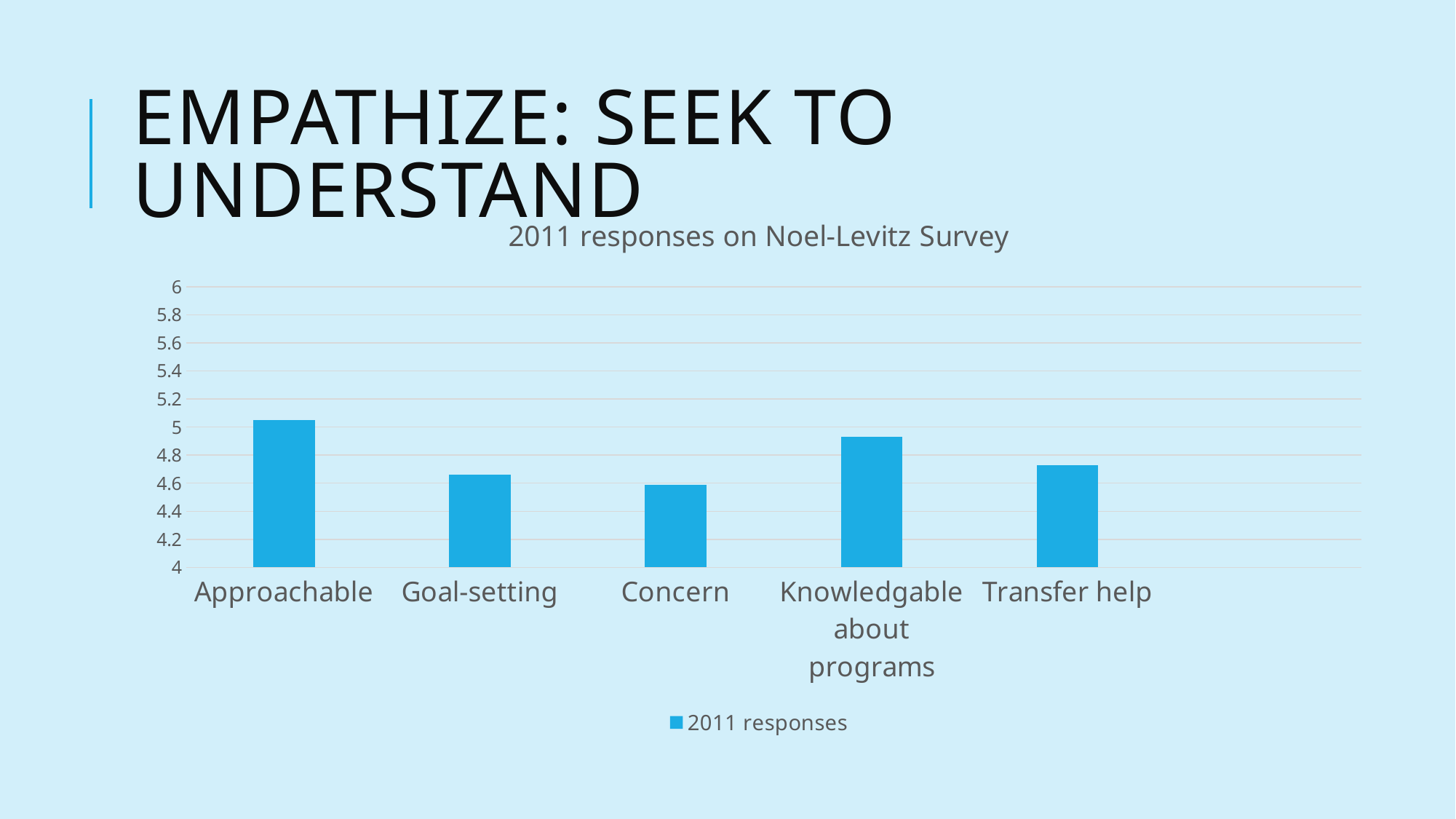
Is the value for Concern greater or less than 4.4? greater What is the title of the chart? 2011 responses on Noel-Levitz Survey Which category has the lowest value in the chart? Concern How many series does the chart legend list? 1 What kind of chart is shown on the slide? bar chart Which is larger, the value for Approachable or the value for Knowledgable about programs? Approachable Which category has the highest value in the chart? Approachable Is the value for Goal-setting greater or less than 4.8? less Which is larger, the value for Concern or the value for Knowledgable about programs? Knowledgable about programs How many categories are shown on the x axis of the chart? 5 Is the value for Approachable greater or less than 4.8? greater